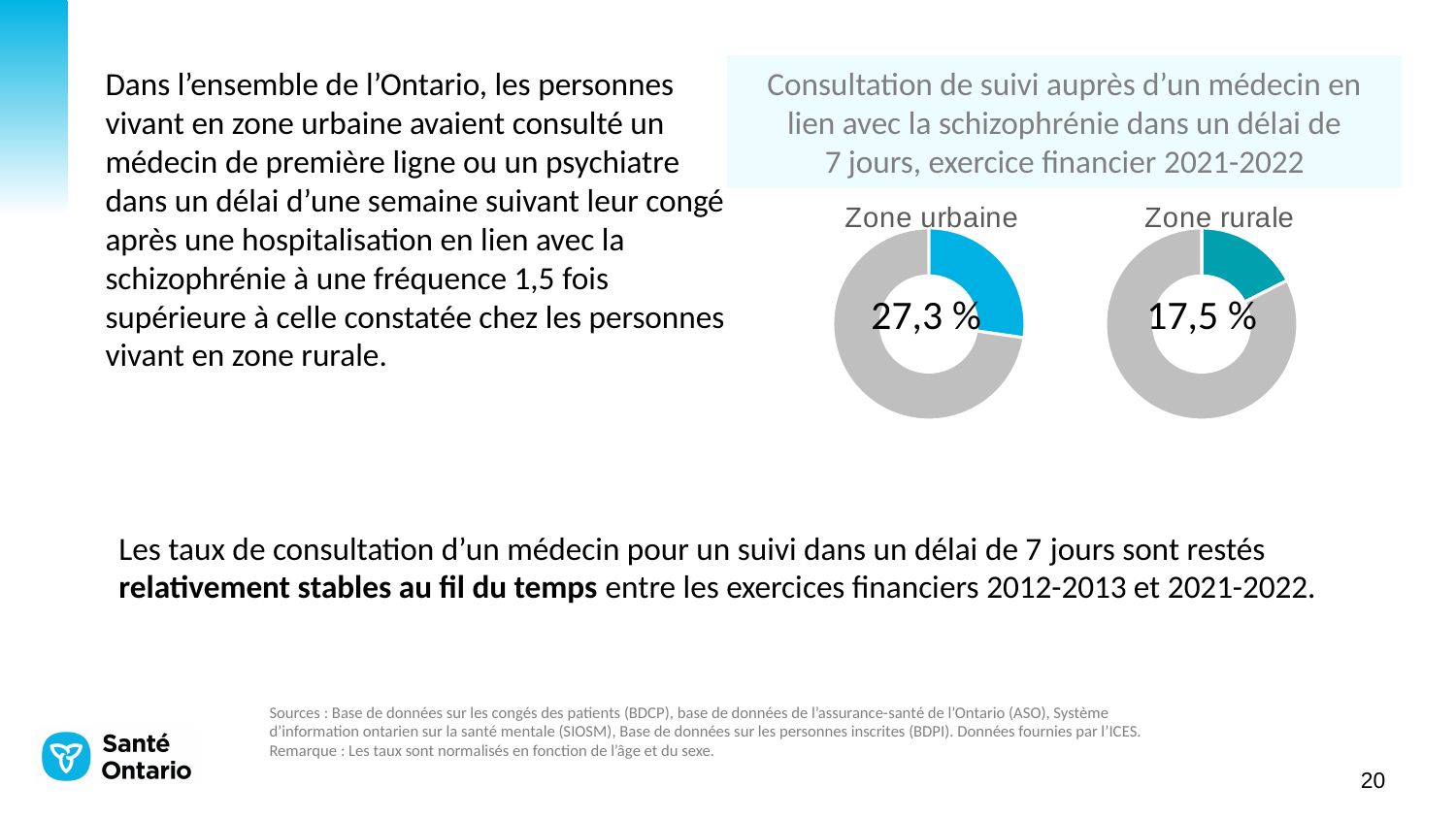
In the 'Zone urbaine' donut chart, what percentage is shown? 27,3 % Which of the two donut charts shows the higher percentage, 'Zone urbaine' or 'Zone rurale'? Zone urbaine How many donut charts are shown on the slide? 2 What colour is the highlighted slice in the 'Zone urbaine' donut chart? Blue What kind of chart is used to show the 'Zone urbaine' and 'Zone rurale' values? Donut (pie) chart Is the value shown in the 'Zone rurale' donut chart greater or less than 20 %? less What fiscal year do the donut charts refer to, according to the chart title? 2021-2022 Which zone has the lowest 7-day follow-up consultation rate shown on the slide? Zone rurale Is the value shown in the 'Zone urbaine' donut chart greater or less than 25 %? greater What is the difference in percentage points between the 'Zone urbaine' value and the 'Zone rurale' value? 9,8 In the 'Zone rurale' donut chart, what percentage is shown? 17,5 % Which zone has the highest 7-day follow-up consultation rate shown on the slide? Zone urbaine